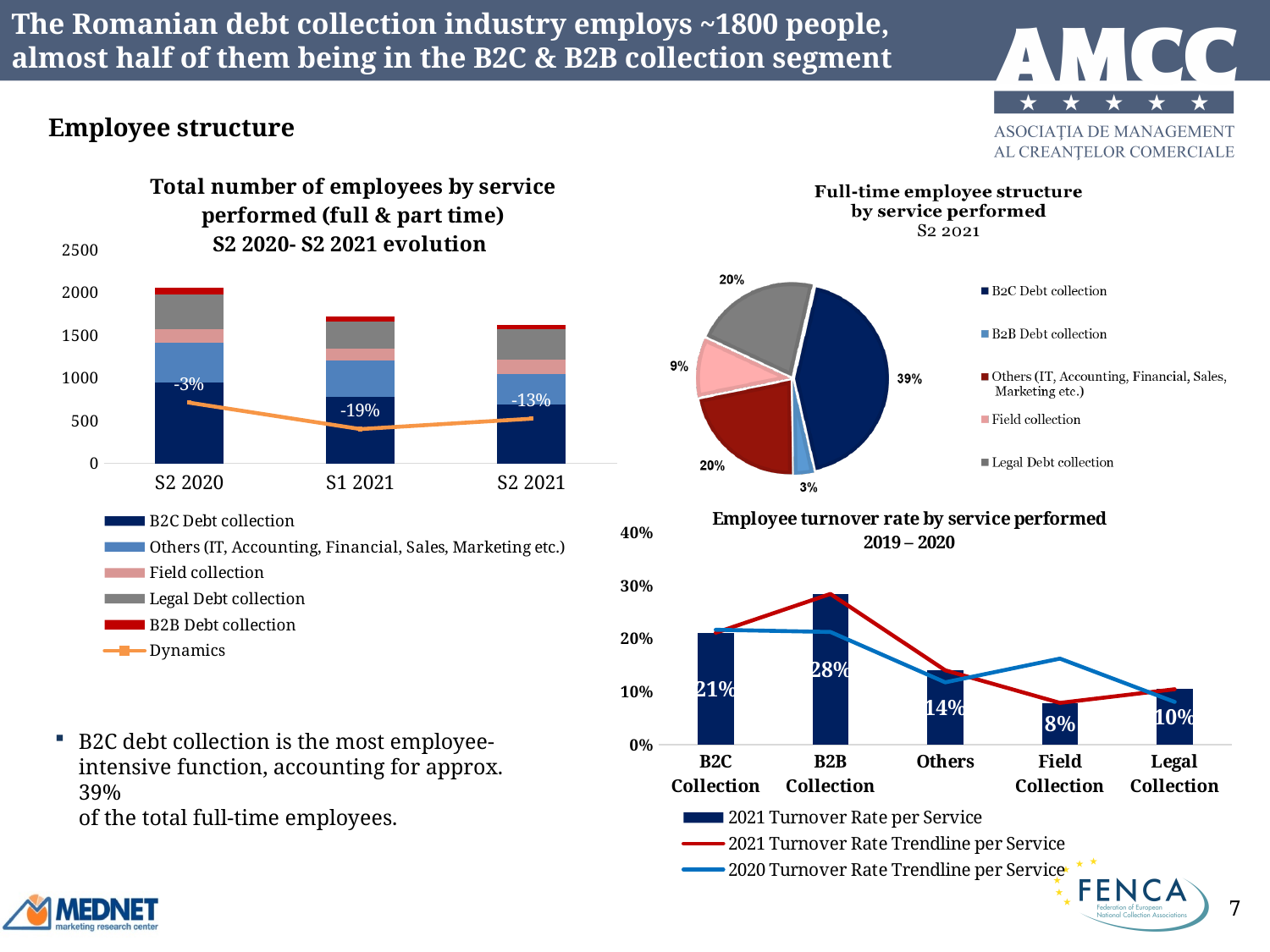
In the 'Employee turnover rate by service performed' chart, what is the 2021 turnover rate for B2B Collection? 28% In the 'Employee turnover rate by service performed' chart, which service has the highest 2021 turnover rate? B2B Collection In the 'Employee turnover rate by service performed' chart, which service has the lowest 2021 turnover rate? Field Collection In the 'Total number of employees by service performed' chart, is the total for S1 2021 greater or less than 2000? less In the 'Full-time employee structure by service performed' pie chart, what share is B2B Debt collection? 3% In the 'Full-time employee structure by service performed' pie chart, what share is B2C Debt collection? 39% In the 'Total number of employees by service performed' chart, how many periods are shown on the x axis? 3 In the 'Employee turnover rate by service performed' chart, how many series does the legend list? 3 What kind of chart is 'Full-time employee structure by service performed'? Pie chart In the 'Full-time employee structure by service performed' pie chart, which is larger: Field collection or Legal Debt collection? Legal Debt collection In the 'Employee turnover rate by service performed' chart, what is the difference between the 2021 turnover rates of B2C Collection and Others? 7% In the 'Total number of employees by service performed' chart, what is the Dynamics value for S1 2021? -19%